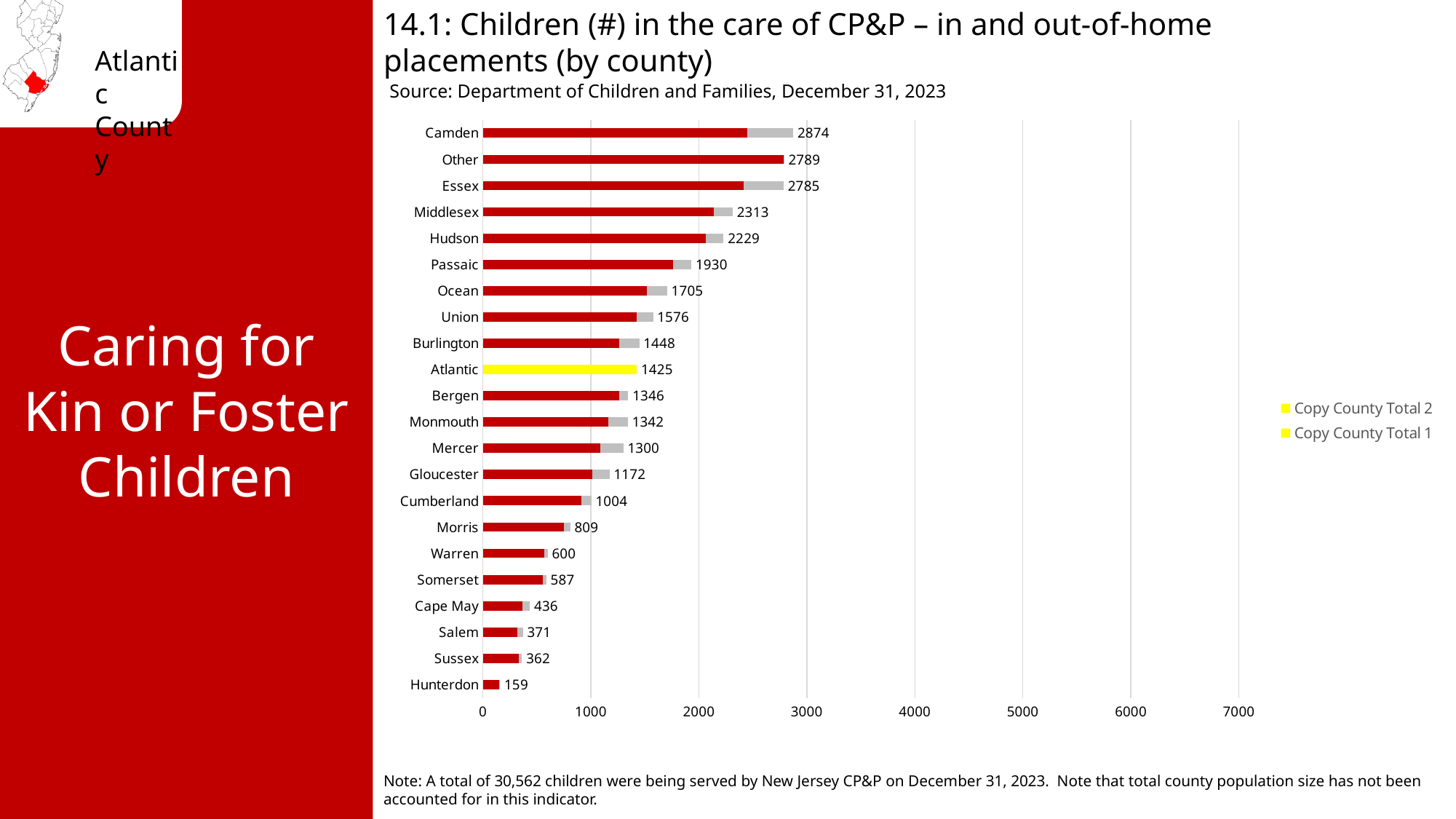
What kind of chart is shown on the slide? Bar chart What is the value shown for Hunterdon? 159 How many counties (categories) are shown on the chart? 22 What is the total number of children in the care of CP&P for Camden? 2874 Which county's bar is highlighted in yellow? Atlantic Which is larger, the value for Passaic or the value for Ocean? Passaic What is the value shown for Atlantic? 1425 Is the value for Middlesex greater or less than 2000? greater Which county has the highest number of children in the care of CP&P? Camden How many series does the legend list? 2 What is the difference between the values for Camden and Hunterdon? 2715 Which county has the lowest number of children in the care of CP&P? Hunterdon